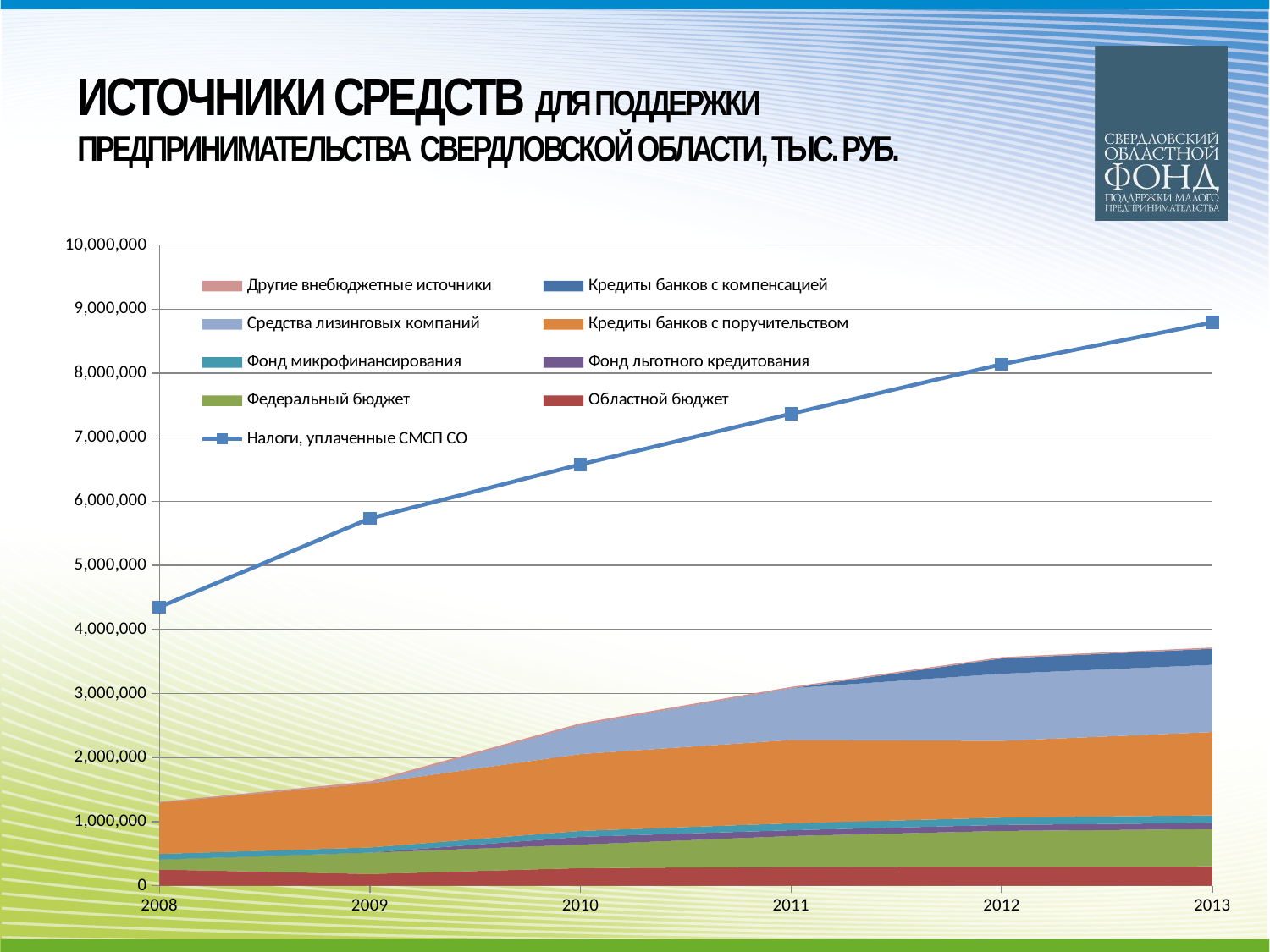
What kind of chart is shown on the slide? A stacked area chart with a line series How many years are shown on the x axis of the chart? 6 Does the line for Налоги, уплаченные СМСП СО rise or fall from 2008 to 2013? Rises In which year is the value of Налоги, уплаченные СМСП СО lowest? 2008 Is the value for Налоги, уплаченные СМСП СО in 2013 greater or less than 8,000,000? greater What is the unit of measurement stated in the chart's title? тыс. руб. In which year is the value of Налоги, уплаченные СМСП СО highest? 2013 Is the value for Налоги, уплаченные СМСП СО in 2011 greater or less than 7,000,000? greater How many series does the chart's legend list? 9 Is the value for Налоги, уплаченные СМСП СО in 2009 greater or less than 6,000,000? less Which series is plotted as a line with square markers rather than as an area? Налоги, уплаченные СМСП СО